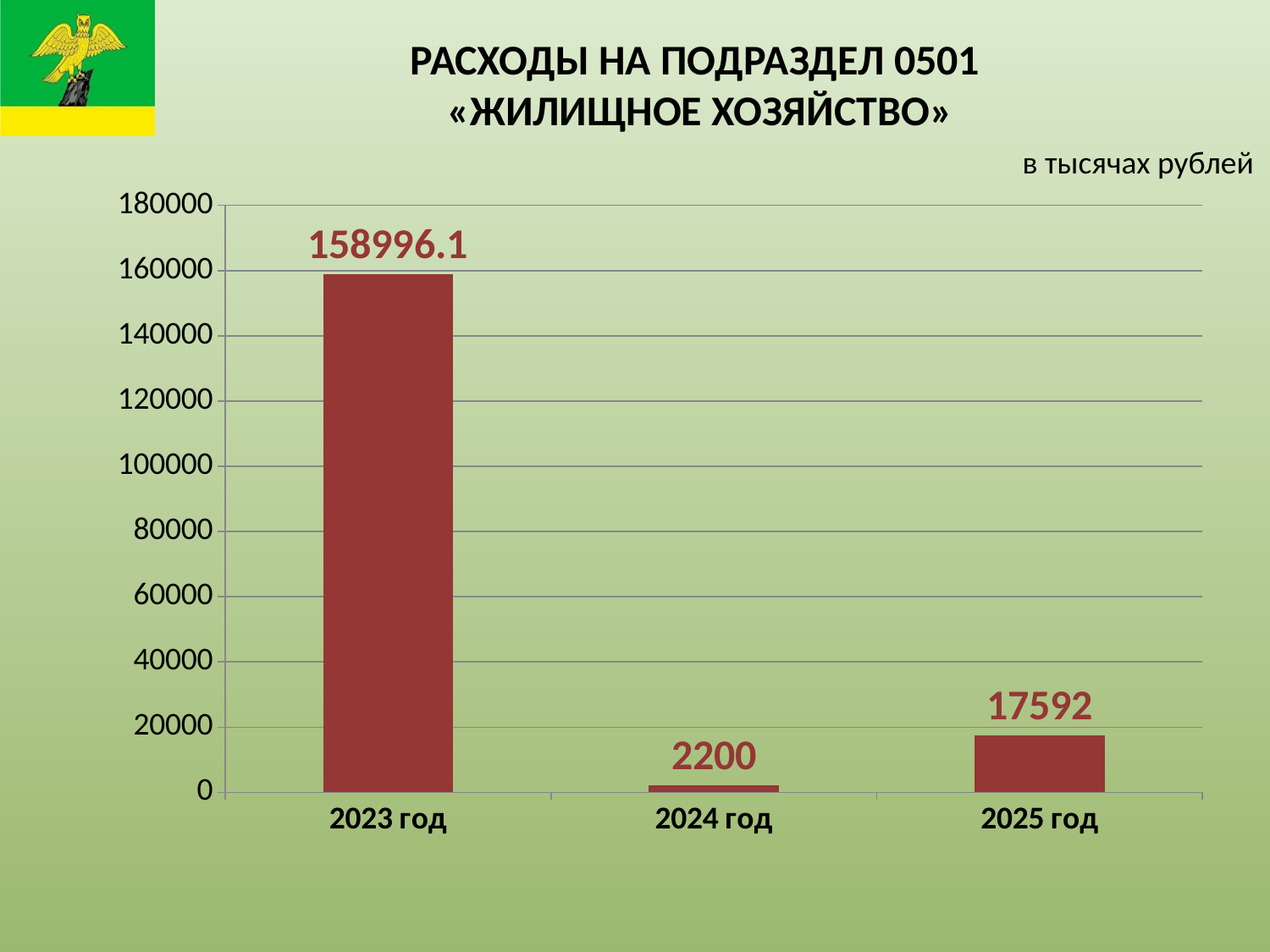
How many years are shown on the chart? 3 Is the value for 2023 год greater or less than 140000? greater Which year has the highest value? 2023 год In what units are the values on the chart given? в тысячах рублей What is the difference between the values for 2025 год and 2024 год? 15392 What is the value for 2023 год? 158996.1 What is the value for 2025 год? 17592 What is the value for 2024 год? 2200 Which year has the lowest value? 2024 год What kind of chart is shown on the slide? bar chart Which is larger, the value for 2024 год or 2025 год? 2025 год What is the difference between the values for 2023 год and 2025 год? 141404.1